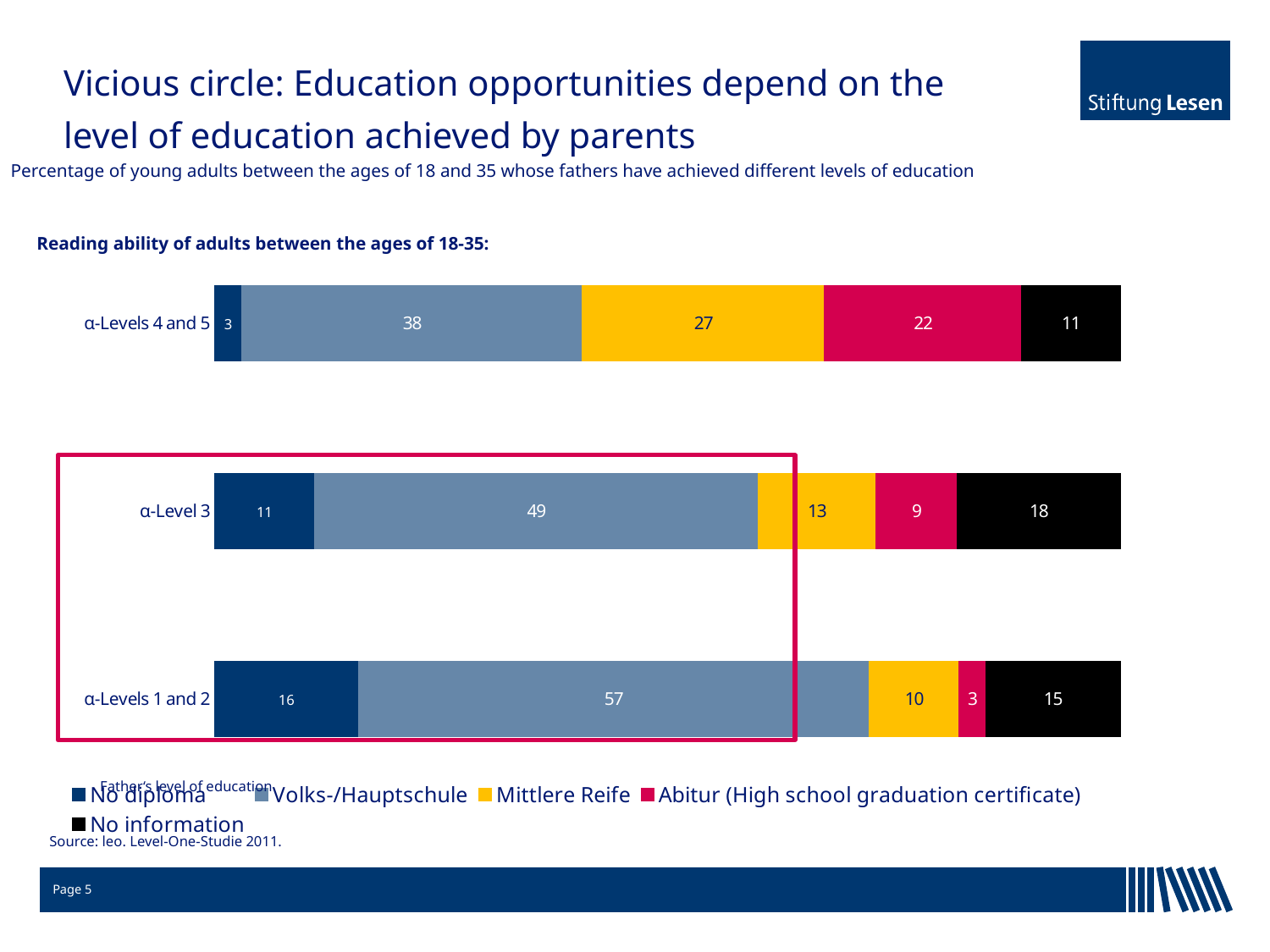
Which category has the highest Volks-/Hauptschule value? α-Levels 1 and 2 What is the difference between the Mittlere Reife values for α-Levels 4 and 5 and α-Levels 1 and 2? 17 What is the No information value for α-Level 3? 18 What is the Volks-/Hauptschule value for α-Levels 1 and 2? 57 How many series does the legend list? 5 Which category has the lowest Abitur (High school graduation certificate) value? α-Levels 1 and 2 What is the total of the stacked bar for α-Level 3? 100 Which is larger: the No diploma value for α-Level 3 or for α-Levels 1 and 2? α-Levels 1 and 2 What is the No diploma value for α-Levels 4 and 5? 3 What is the Abitur (High school graduation certificate) value for α-Levels 4 and 5? 22 How many reading-ability categories are plotted in the chart? 3 What kind of chart is shown on the slide? Stacked bar chart